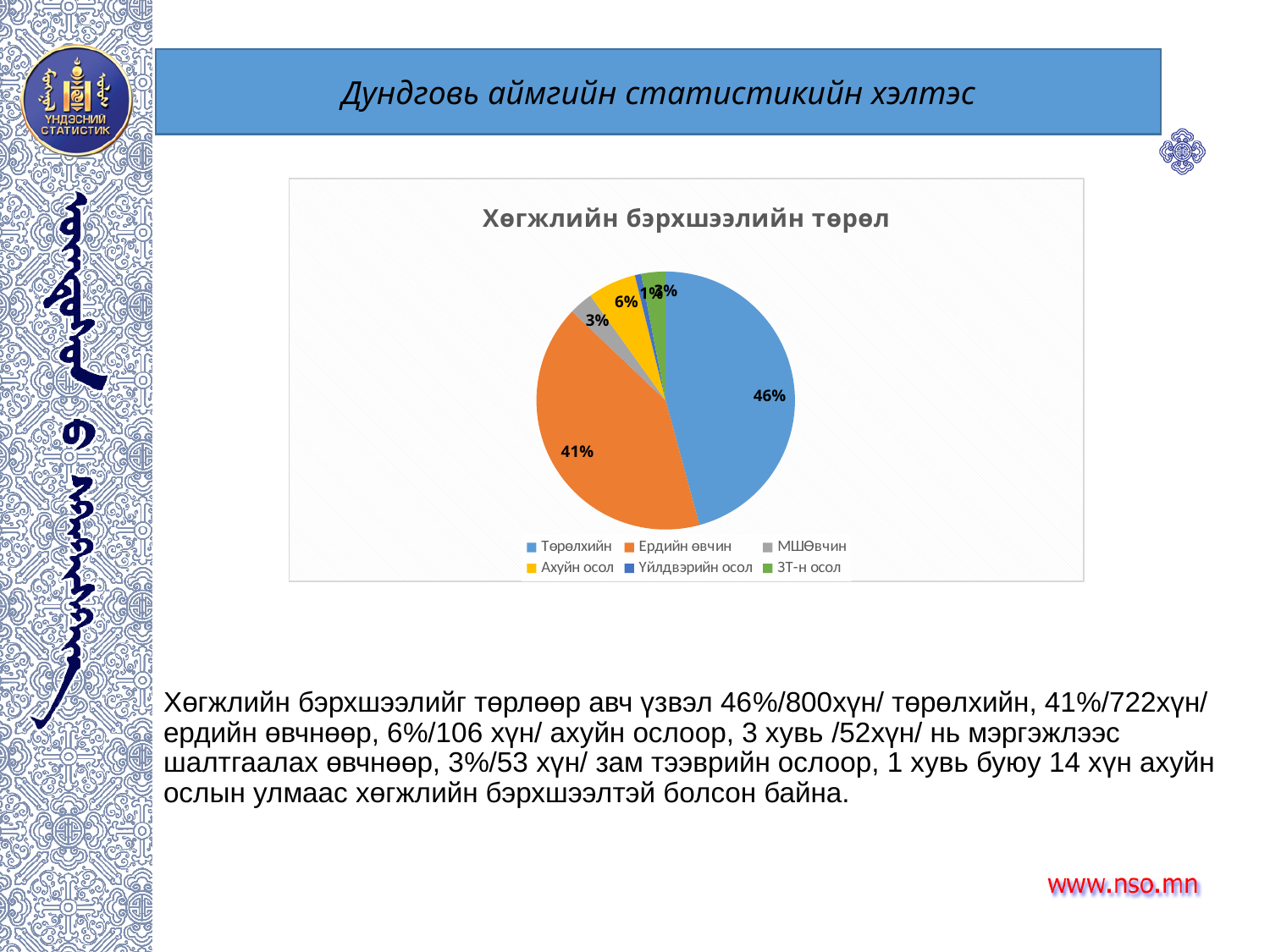
What share of the pie does Ердийн өвчин have? 41% What share of the pie does Төрөлхийн have? 46% What is the difference in percentage points between Төрөлхийн and Ердийн өвчин? 5 percentage points Which is larger, the slice for Ахуйн осол or the slice for МШӨвчин? Ахуйн осол What is the value shown for Ахуйн осол? 6% What colour is the slice for Ердийн өвчин? orange What is the title of the chart? Хөгжлийн бэрхшээлийн төрөл Which category has the smallest slice of the pie? Үйлдвэрийн осол How many categories does the pie chart have? 6 What is the value shown for МШӨвчин? 3% What kind of chart is shown on the slide? pie chart Which category has the largest slice of the pie? Төрөлхийн